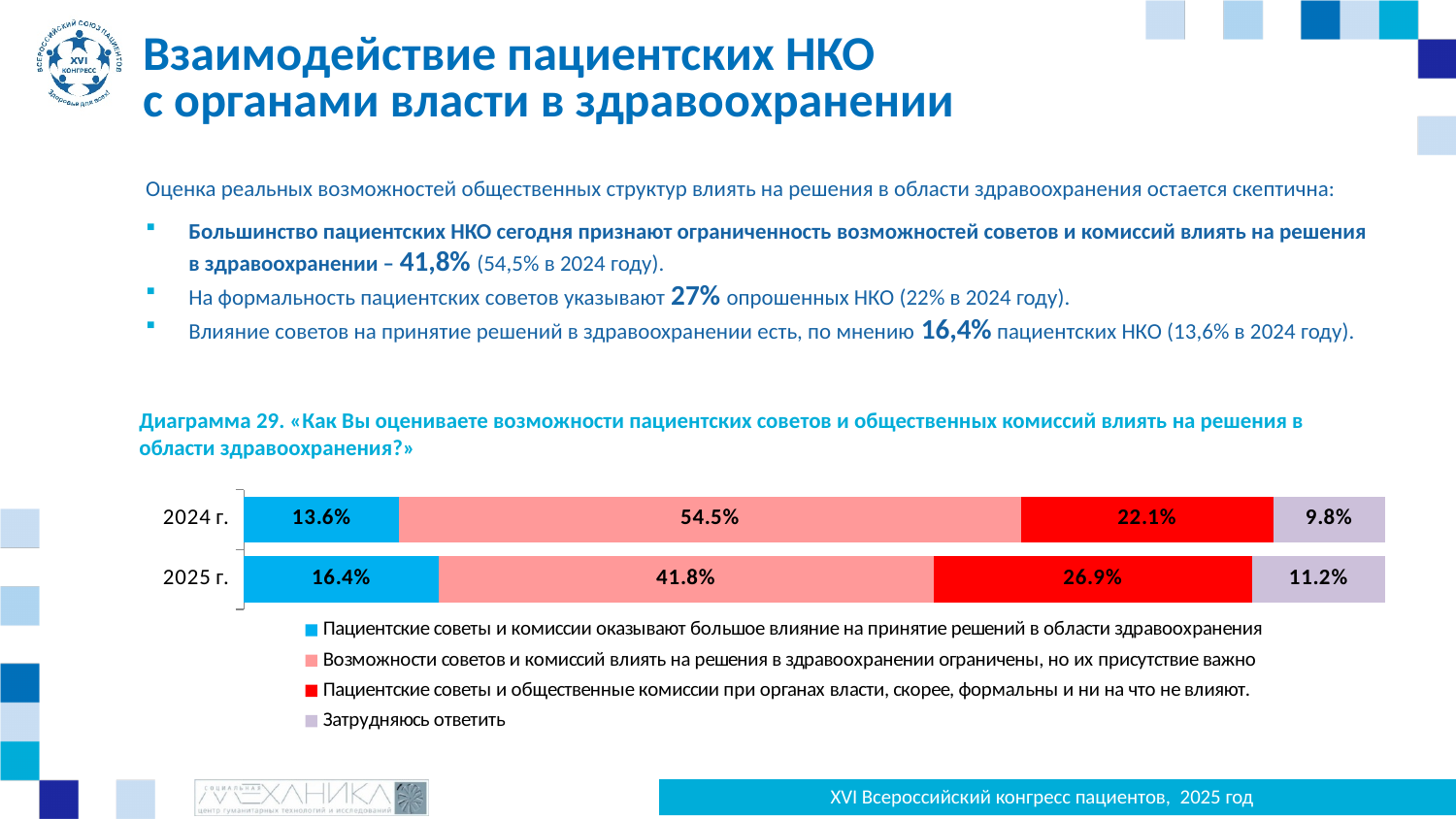
Какова доля ответа «Затрудняюсь ответить» в 2024 г.? 9.8% Какой вариант ответа имеет наименьшую долю в 2024 г.? Затрудняюсь ответить В каком году доля ответа «Пациентские советы и общественные комиссии ... формальны и ни на что не влияют» была больше: в 2024 г. или в 2025 г.? 2025 г. Какой вариант ответа имеет наибольшую долю в 2025 г.? Возможности советов и комиссий влиять на решения в здравоохранении ограничены, но их присутствие важно Какова доля ответа «Пациентские советы и комиссии оказывают большое влияние на принятие решений в области здравоохранения» в 2025 г.? 16.4% Сколько серий перечислено в легенде диаграммы 29? 4 Какова доля ответа «Пациентские советы и общественные комиссии при органах власти, скорее, формальны и ни на что не влияют» в 2025 г.? 26.9% Сколько категорий (лет) показано на диаграмме 29? 2 Какой тип диаграммы показан на слайде (Диаграмма 29)? Столбчатая (линейчатая) диаграмма с накоплением Какова сумма всех долей в столбце 2024 г.? 100% На сколько процентных пунктов снизилась доля ответа «Возможности советов и комиссий влиять на решения ограничены, но их присутствие важно» с 2024 г. по 2025 г.? 12.7 процентных пункта Какова доля ответа «Возможности советов и комиссий влиять на решения в здравоохранении ограничены, но их присутствие важно» в 2024 г.? 54.5%